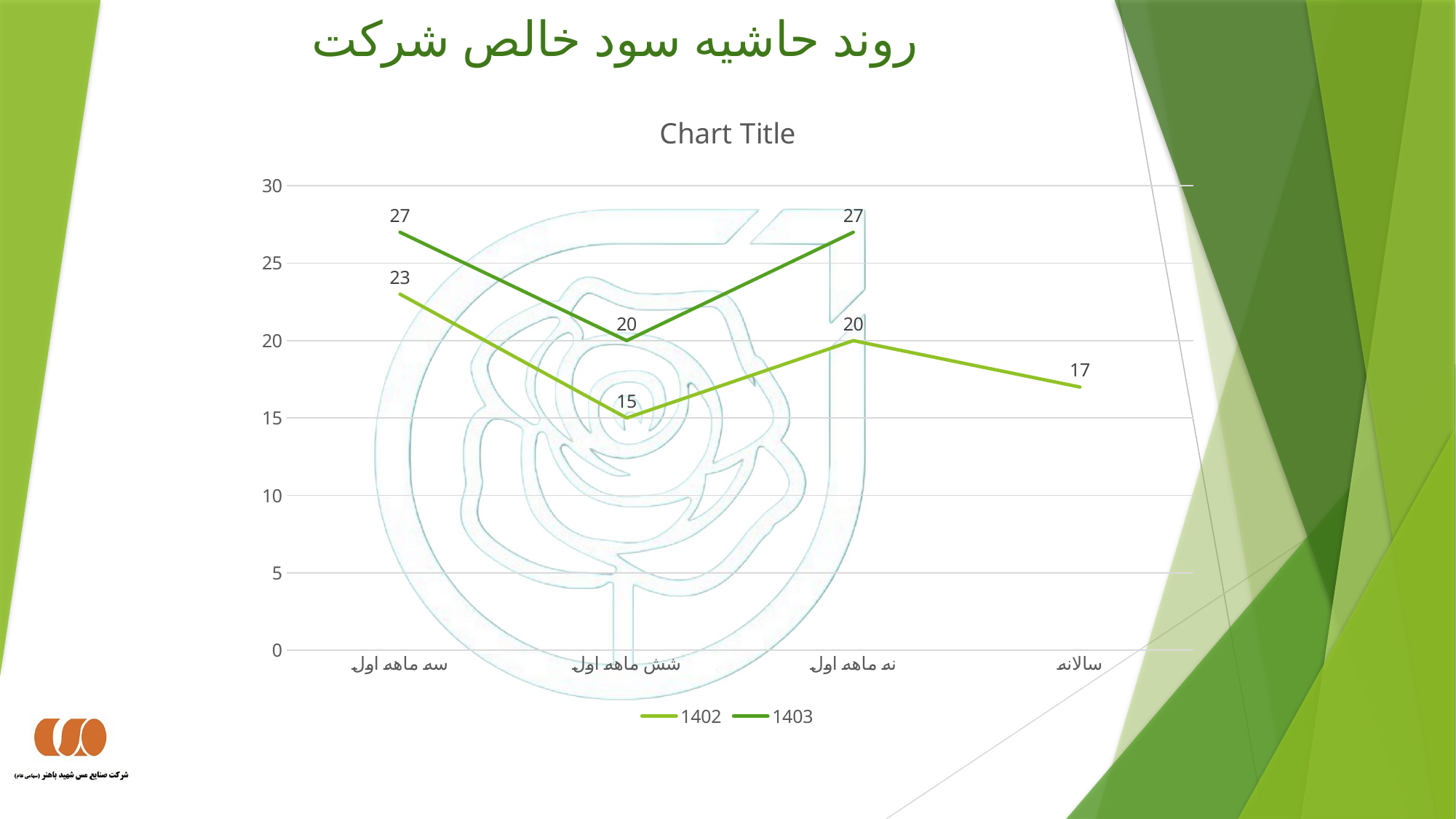
How many series does the legend list? 2 What is the value of the 1403 series for نه ماهه اول? 27 What is the value of the 1402 series for سه ماهه اول? 23 How many categories are shown on the x axis? 4 What kind of chart is shown on the slide? line chart What is the value of the 1402 series for سالانه? 17 What is the difference between the 1403 and 1402 values for سه ماهه اول? 4 Does the 1402 series rise or fall from نه ماهه اول to سالانه? fall What is the value of the 1403 series for شش ماهه اول? 20 What is the title printed above the chart? Chart Title Which series has the larger value for شش ماهه اول, 1402 or 1403? 1403 For which category is the 1402 series lowest? شش ماهه اول